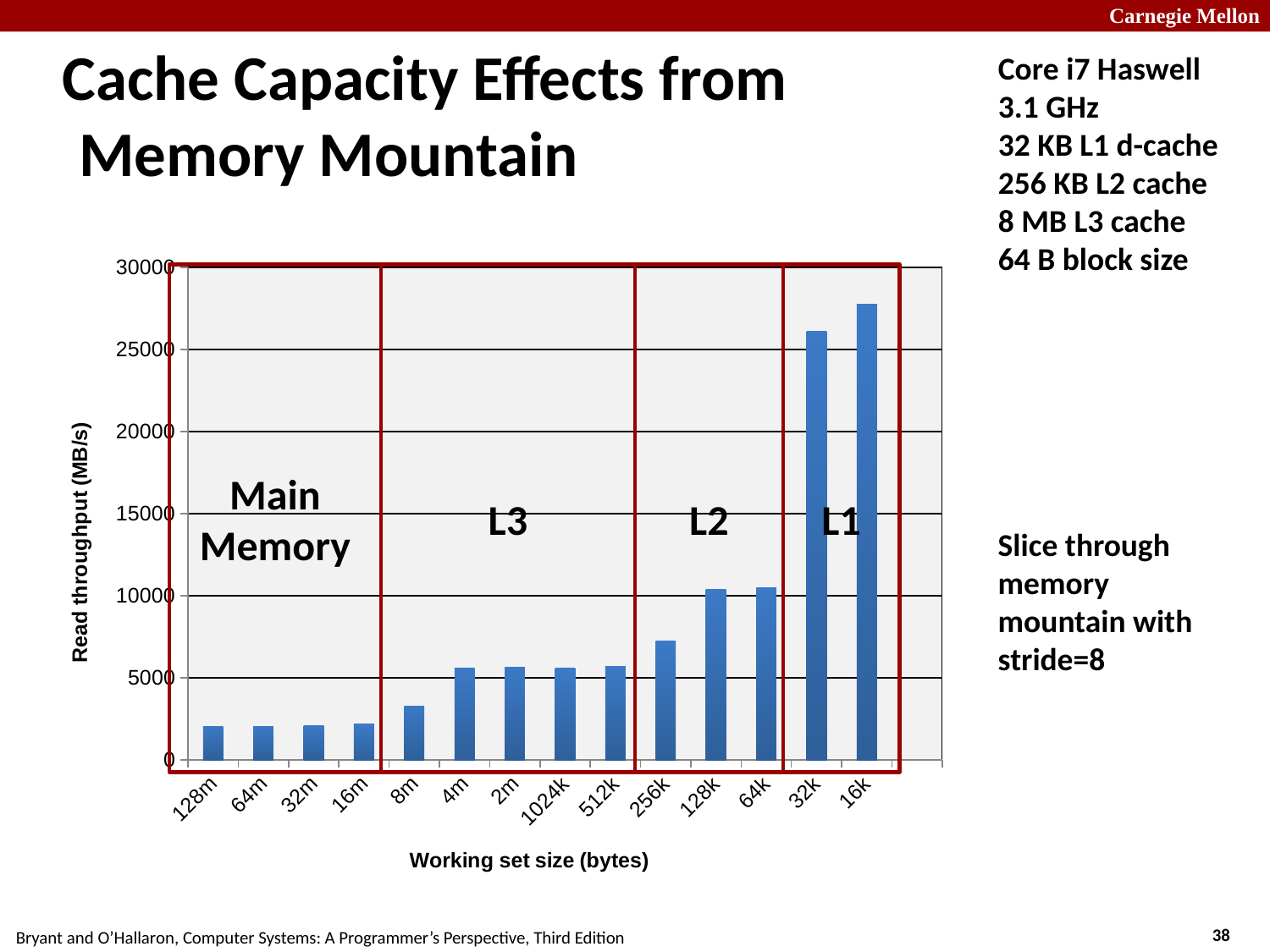
Which cache level region is labeled over the two rightmost bars? L1 Is the read throughput for a working set size of 8m greater or less than 5000? less Which working set size has the highest read throughput? 16k Which has the higher read throughput, a working set size of 256k or 128k? 128k Do the read throughput values generally rise or fall moving from left to right along the x axis? rise How many working set sizes are plotted along the x axis? 14 Which has the higher read throughput, a working set size of 32k or 16k? 16k Is the read throughput for a working set size of 256k greater or less than 10000? less Is the read throughput for a working set size of 32k greater or less than 25000? greater What is the label of the y axis? Read throughput (MB/s) What kind of chart is shown on the slide? bar chart